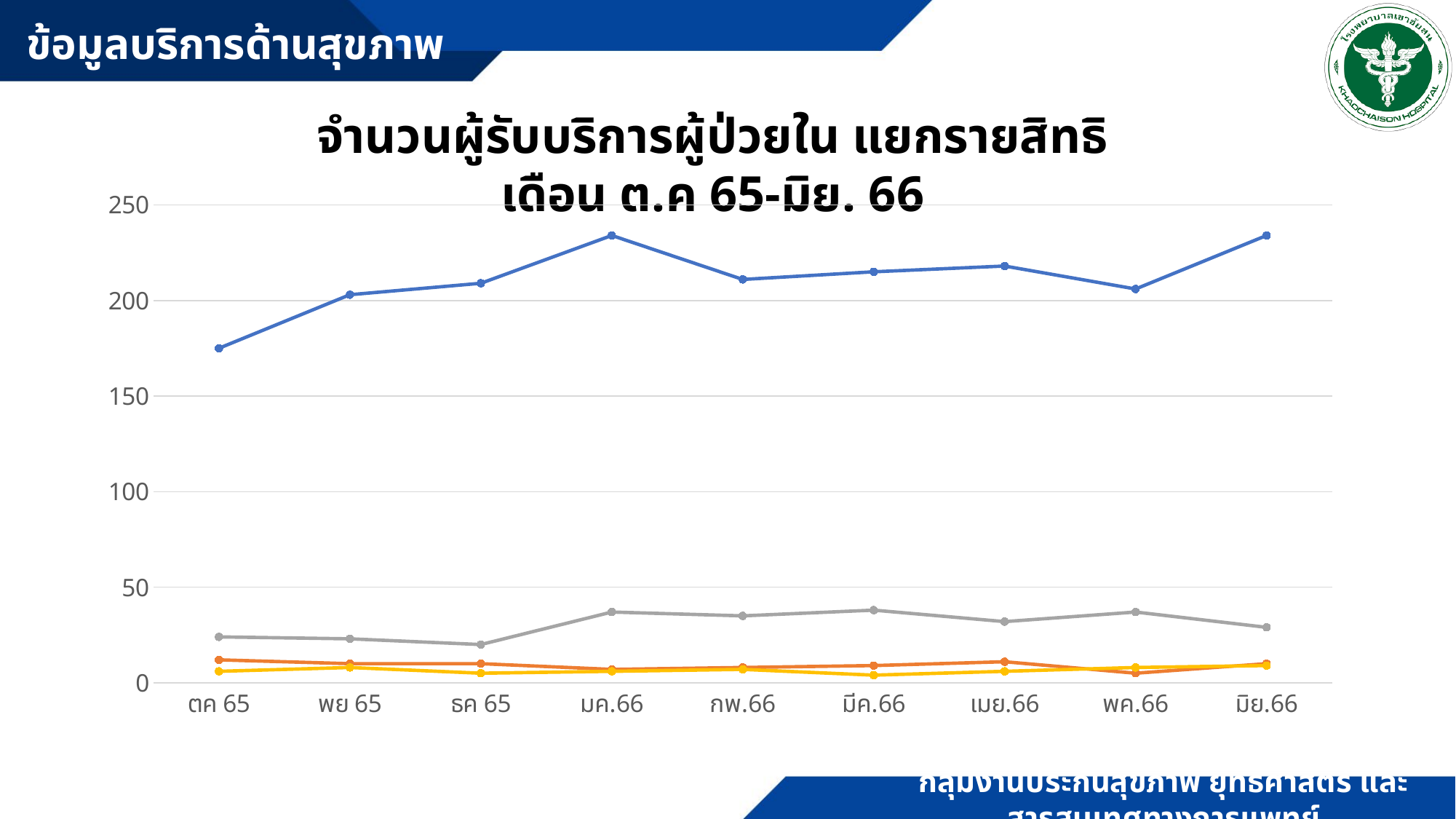
At กพ.66, which line has the larger value, the blue line or the gray line? the blue line Does the blue line overall rise or fall from ตค 65 to มิย.66? rise Is the value of the blue line for มค.66 greater or less than 200? greater What is the first line of the chart's title? จำนวนผู้รับบริการผู้ป่วยใน แยกรายสิทธิ Is the value of the gray line for มีค.66 greater or less than 50? less What kind of chart is shown on the slide? line chart Is the value of the blue line for มิย.66 greater or less than 200? greater How many lines are plotted on the chart? 4 Which month has the lowest value on the blue line? ตค 65 Which month has the lowest value on the gray line? ธค 65 How many months are shown along the x axis of the chart? 9